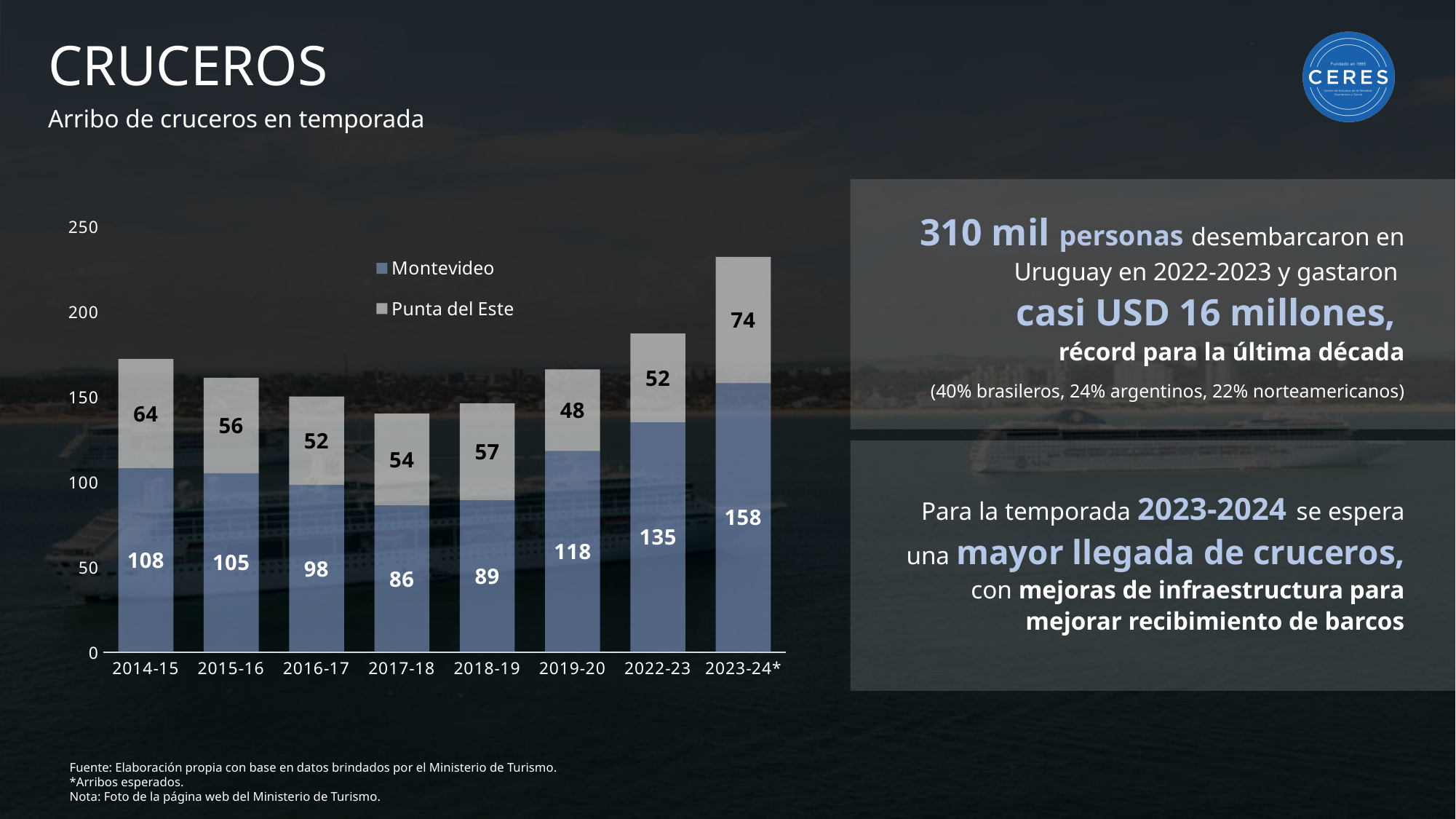
In which season is the Montevideo value lowest? 2017-18 What is the Montevideo value for the 2019-20 season? 118 In which season is the Punta del Este value lowest? 2019-20 How many seasons are shown on the x axis of the chart? 8 How many series does the chart legend list? 2 What is the total of the stacked bar for the 2023-24* season? 232 What are the two series named in the chart legend? Montevideo and Punta del Este In which season is the Montevideo value highest? 2023-24* Which season has the larger Punta del Este value, 2014-15 or 2015-16? 2014-15 What is the difference between the Montevideo values for 2022-23 and 2019-20? 17 What kind of chart is shown on the slide? Stacked bar chart What is the Punta del Este value for the 2023-24* season? 74